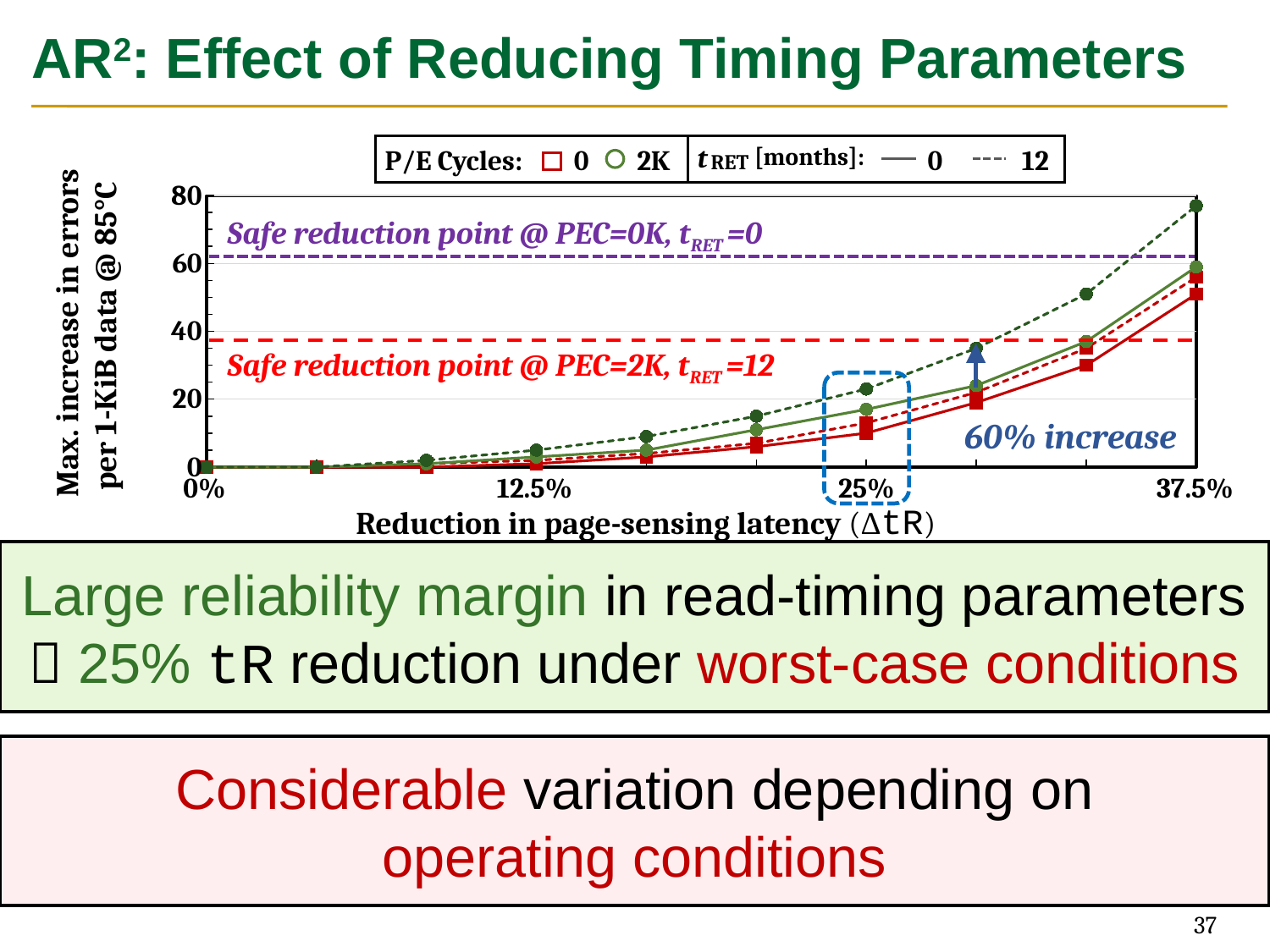
What kind of chart is shown on the slide? line chart Is the value for P/E Cycles 2K, tRET 12 months at a 37.5% reduction greater or less than 60? greater At a 37.5% reduction, which is larger: the value for P/E Cycles 2K, tRET 12 months or the value for P/E Cycles 0, tRET 0 months? P/E Cycles 2K, tRET 12 months How many P/E cycle values does the legend list? 2 Which series has the highest value at a 37.5% reduction in page-sensing latency? P/E Cycles 2K, tRET 12 months Is the value for P/E Cycles 2K, tRET 12 months at a 25% reduction greater or less than 20? greater What is the label of the y axis? Max. increase in errors per 1-KiB data @ 85°C Is the value for P/E Cycles 0, tRET 0 months at a 25% reduction greater or less than 20? less How many tRET values does the legend list? 2 What is the label of the x axis? Reduction in page-sensing latency (ΔtR) Which series has the lowest value at a 37.5% reduction in page-sensing latency? P/E Cycles 0, tRET 0 months Do the plotted values rise or fall as the reduction in page-sensing latency increases? rise